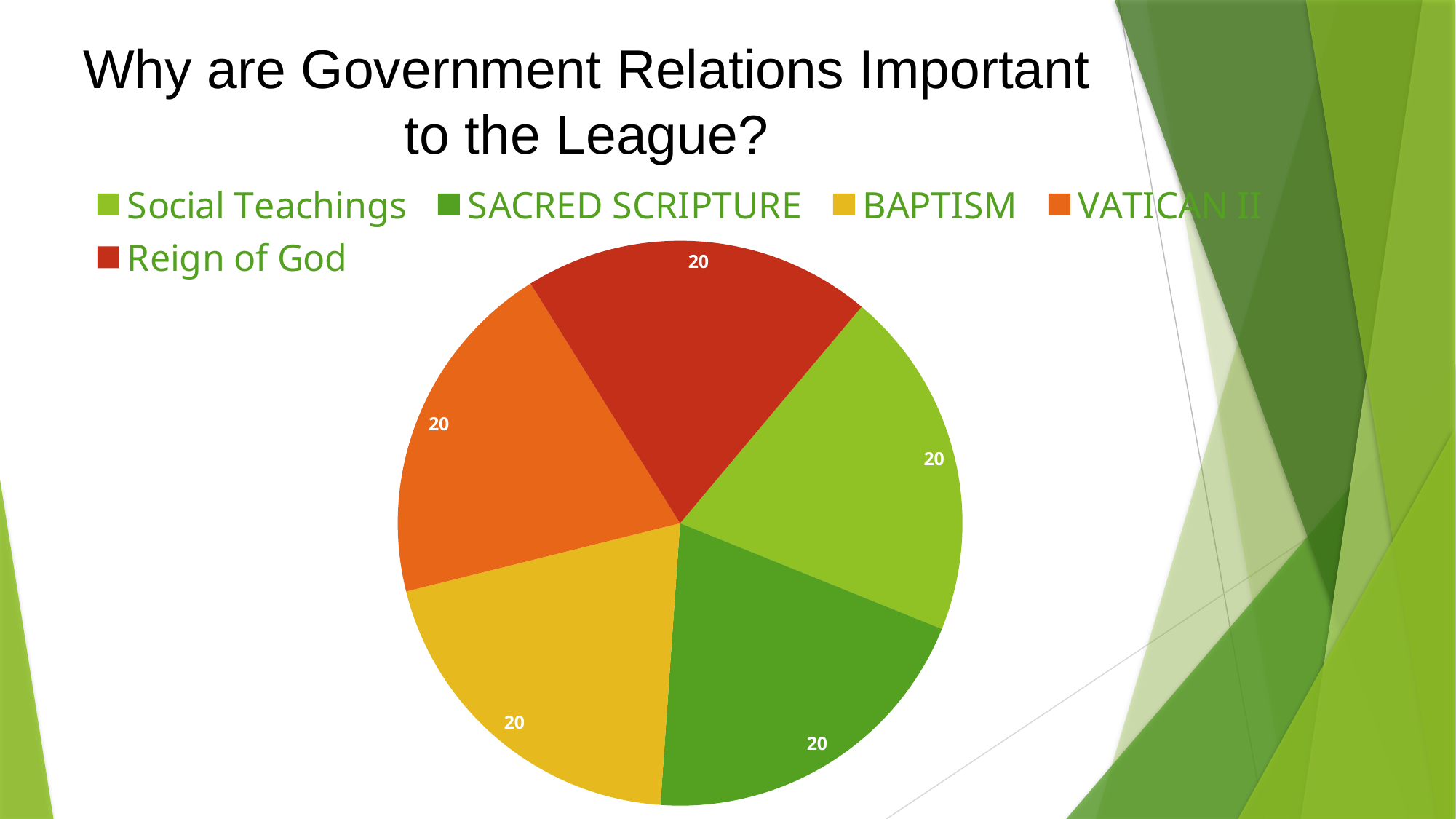
What is the value shown for the SACRED SCRIPTURE slice? 20 What is the title of the slide containing the pie chart? Why are Government Relations Important to the League? What kind of chart is shown on the slide? pie chart What is the total of all the slice values in the pie chart? 100 What is the difference between the values for BAPTISM and VATICAN II? 0 What is the value shown for the BAPTISM slice? 20 How many entries does the legend list? 5 How many slices does the pie chart have? 5 Which legend entry is shown in yellow? BAPTISM What is the value shown for the Reign of God slice? 20 What is the value shown for the Social Teachings slice? 20 What share of the pie does the Reign of God slice represent? 20%